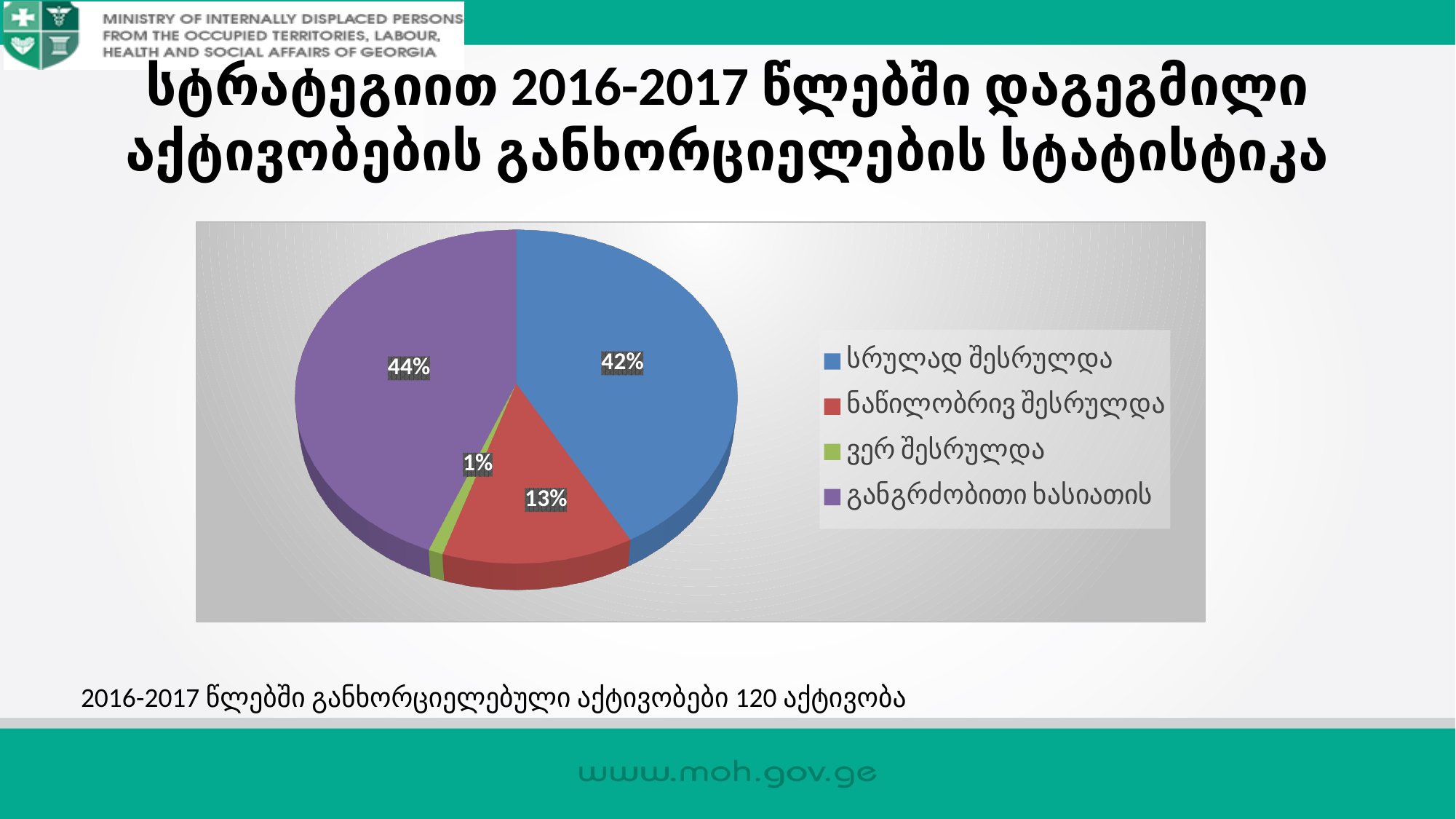
What share of the pie does ნაწილობრივ შესრულდა have? 13% What share of the pie does განგრძობითი ხასიათის have? 44% Which is larger, the slice for სრულად შესრულდა or the slice for ნაწილობრივ შესრულდა? სრულად შესრულდა What colour is the slice for განგრძობითი ხასიათის? purple What share of the pie does ვერ შესრულდა have? 1% What is the difference in percentage points between სრულად შესრულდა and ნაწილობრივ შესრულდა? 29 What kind of chart is shown on the slide? pie chart How many categories does the pie chart show? 4 Which category has the smallest slice of the pie? ვერ შესრულდა What colour is the slice for ნაწილობრივ შესრულდა? red Which category has the largest slice of the pie? განგრძობითი ხასიათის